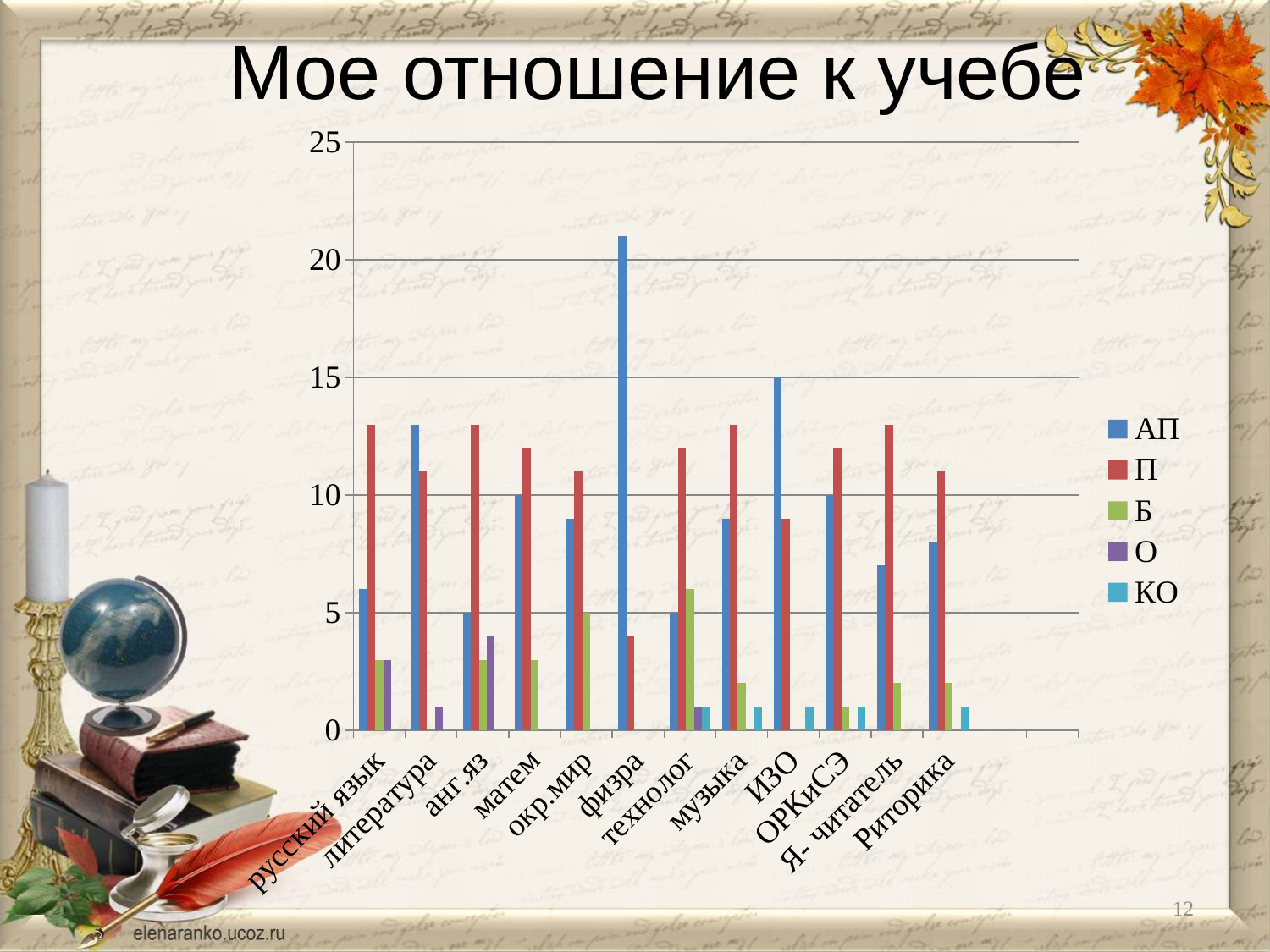
What kind of chart is shown on the slide? bar chart Is the АП value for физра greater or less than 20? greater Which category has the highest АП value? физра Is the П value for русский язык greater or less than 10? greater What is the title of the chart? Мое отношение к учебе How many series does the legend list? 5 For русский язык, which is larger: the АП value or the П value? П Is the П value for физра greater or less than 5? less For физра, which is larger: the АП value or the П value? АП What is the АП value for ИЗО? 15 How many categories are shown on the x axis? 12 Which series is listed last in the legend? КО